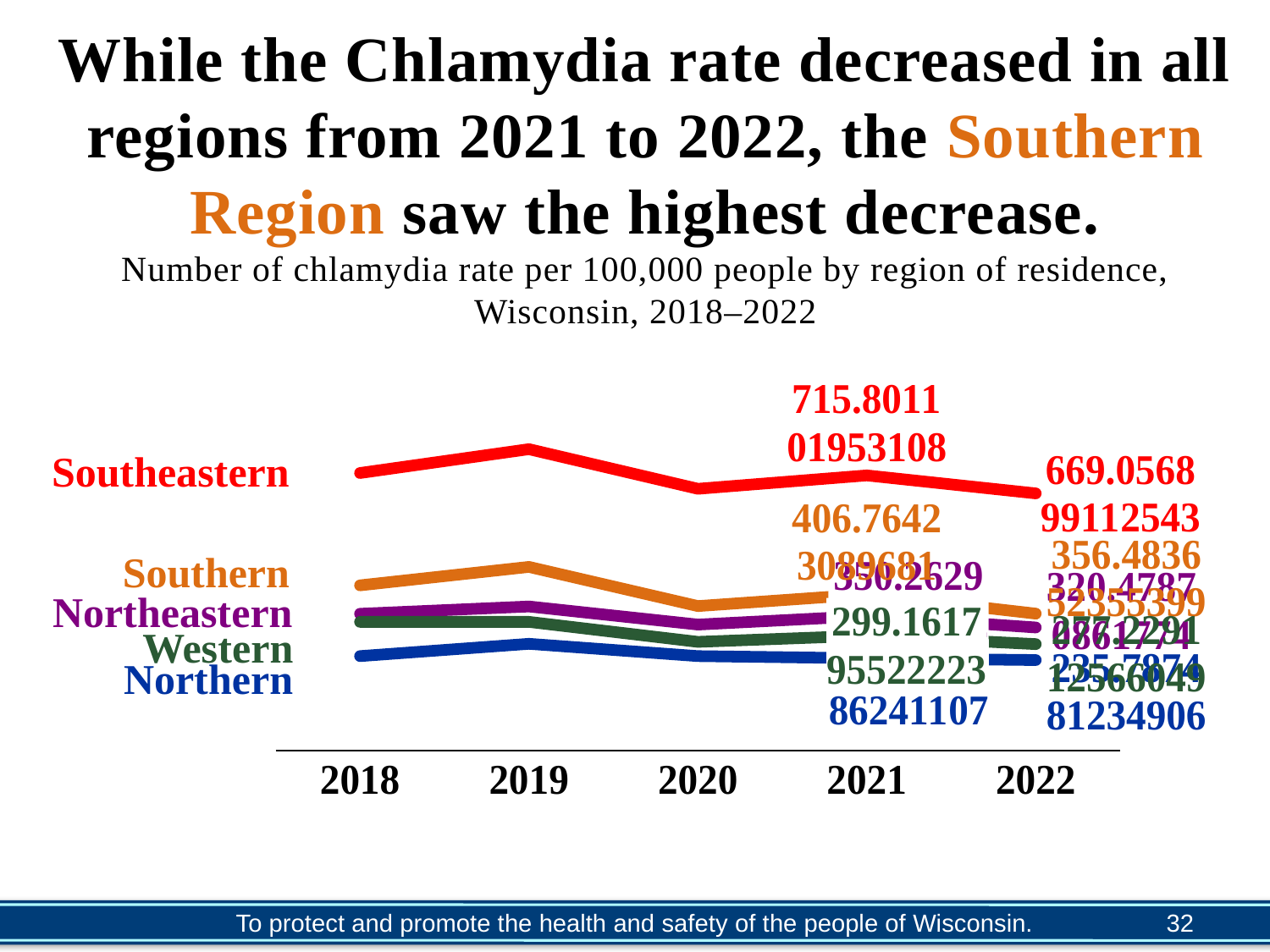
What colour is the line for the Southeastern region? Red How many years are shown along the x axis of the chart? 5 Does the Southeastern region's rate rise or fall from 2021 to 2022? Fall Which region has the lowest chlamydia rate in 2022? Northern What is the chlamydia rate for the Southeastern region in 2022? 669.056899112543 How many regions (series) are plotted on the chart? 5 What kind of chart is shown on the slide? Line chart What is the chlamydia rate for the Southeastern region in 2021? 715.801101953108 Does the Southeastern region's rate rise or fall from 2018 to 2019? Rise For the Southeastern region, which year has the higher rate, 2021 or 2022? 2021 Which region has the highest chlamydia rate in 2022? Southeastern In 2018, which region has the higher rate, Southern or Northern? Southern